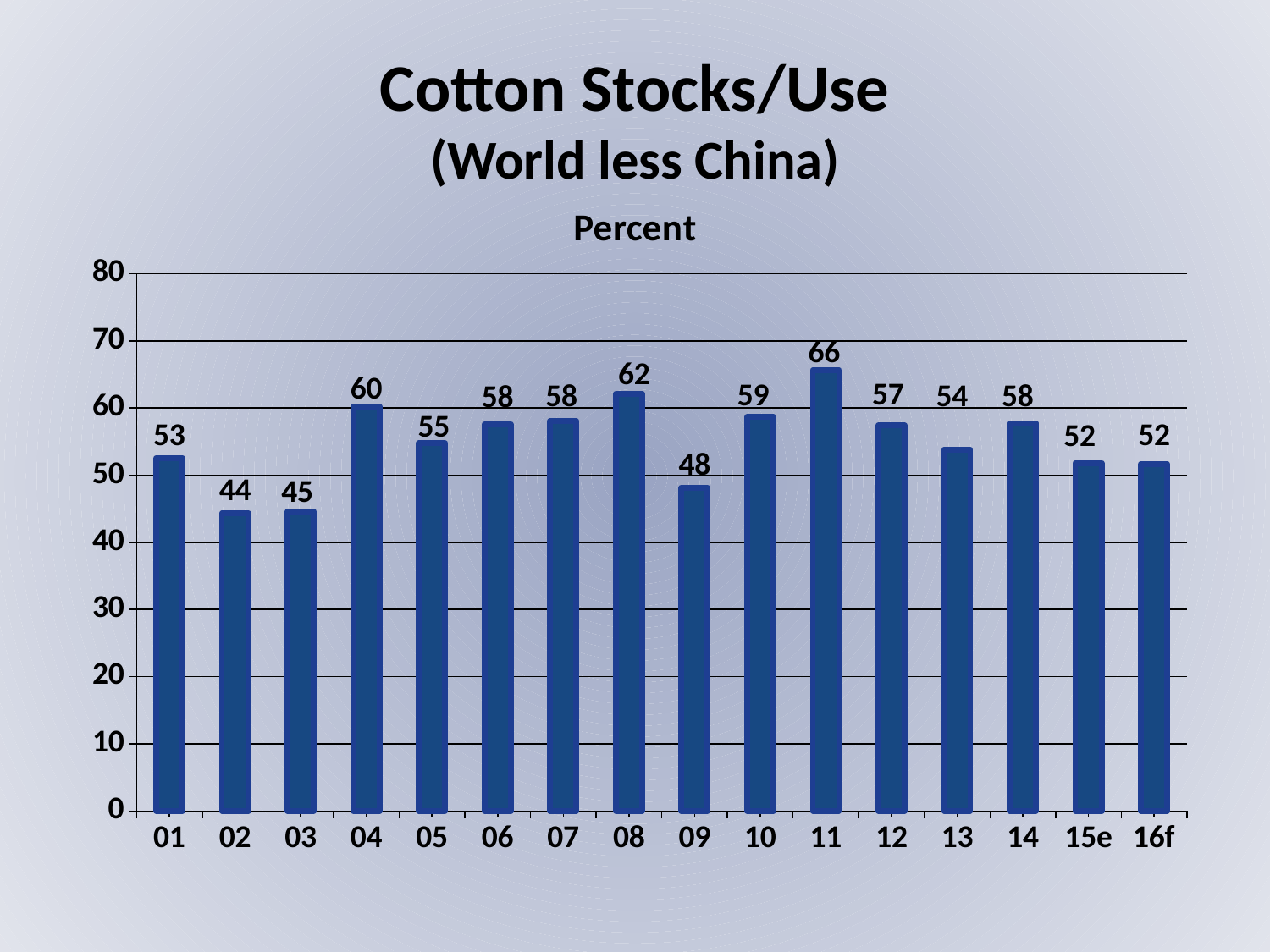
What is the value shown for 09? 48 Which year has the highest stocks/use value? 11 What is the difference between the values for 08 and 09? 14 What kind of chart is shown on the slide? bar chart Which year has the lowest stocks/use value? 02 What is the cotton stocks/use value for 11? 66 What is the difference between the values for 11 and 02? 22 Which is larger, the value for 04 or the value for 13? 04 What is the title of the chart? Cotton Stocks/Use (World less China) How many years are shown on the x axis? 16 What is the value shown for 15e? 52 Is the value for 11 greater or less than 60? greater